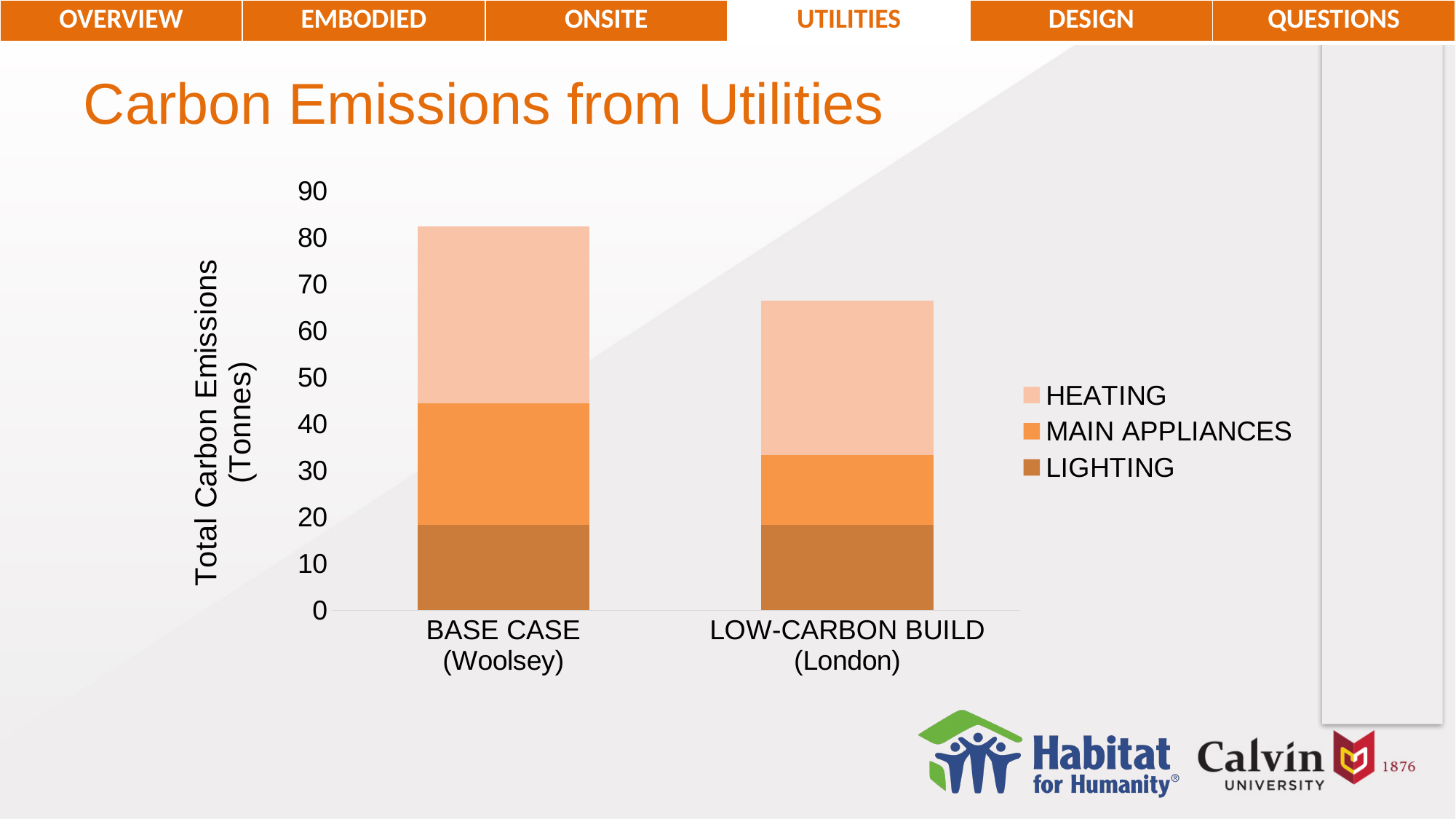
Which series is shown in the lightest colour in the chart's legend? HEATING What kind of chart is shown on the slide? Stacked bar chart Is the total bar for LOW-CARBON BUILD (London) greater or less than 60? greater Is the total bar for BASE CASE (Woolsey) greater or less than 70? greater Is the total bar for LOW-CARBON BUILD (London) greater or less than 70? less How many series does the chart's legend list? 3 Which category has the larger MAIN APPLIANCES segment, BASE CASE (Woolsey) or LOW-CARBON BUILD (London)? BASE CASE (Woolsey) What is the label of the vertical axis of the chart? Total Carbon Emissions (Tonnes) How many categories are shown on the x axis of the chart? 2 Which category has the highest total bar in the chart? BASE CASE (Woolsey) Which category has the higher total carbon emissions, BASE CASE (Woolsey) or LOW-CARBON BUILD (London)? BASE CASE (Woolsey)